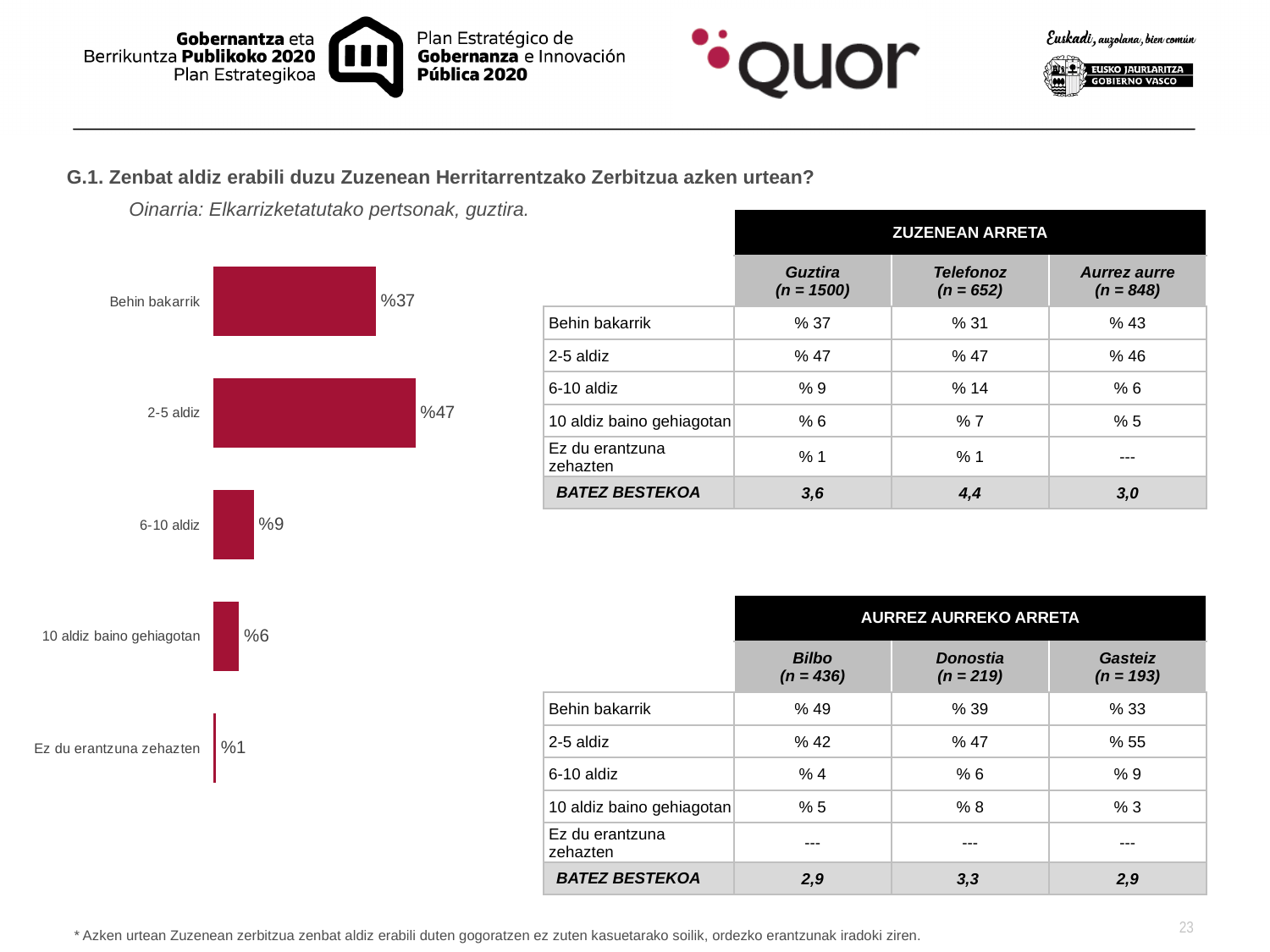
What is the value for "6-10 aldiz" in the bar chart? %9 What is the difference between the values for "Behin bakarrik" and "6-10 aldiz" in the bar chart? %28 What is the value for "Behin bakarrik" in the bar chart? %37 Which category has the lowest value in the bar chart? Ez du erantzuna zehazten What is the difference between the values for "2-5 aldiz" and "Behin bakarrik" in the bar chart? %10 Which category has the highest value in the bar chart? 2-5 aldiz Which is larger in the bar chart, the value for "6-10 aldiz" or the value for "10 aldiz baino gehiagotan"? 6-10 aldiz What is the value for "10 aldiz baino gehiagotan" in the bar chart? %6 What type of chart is shown on the slide? Bar chart What is the value for "2-5 aldiz" in the bar chart? %47 What is the value for "Ez du erantzuna zehazten" in the bar chart? %1 How many categories are shown in the bar chart? 5